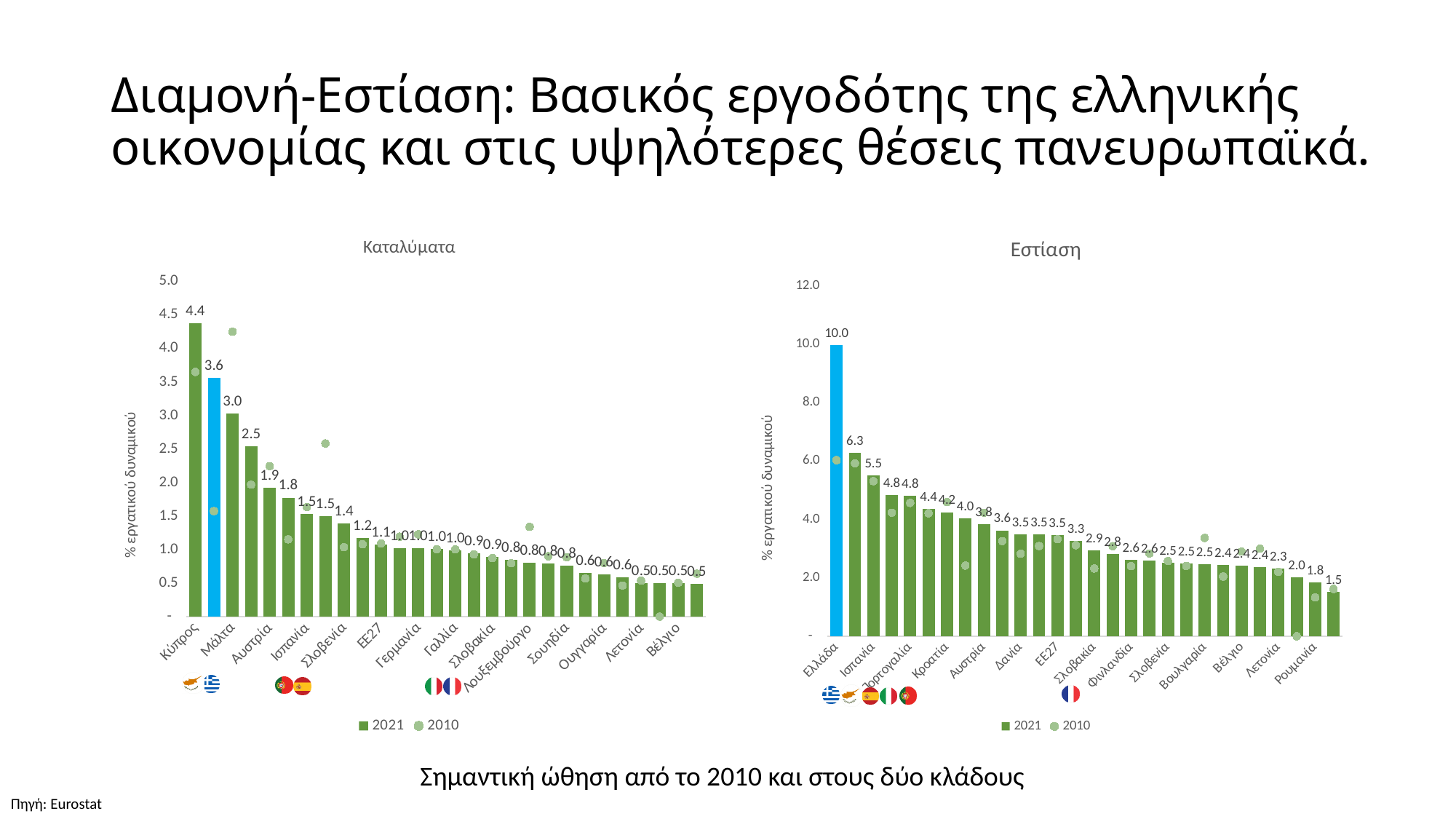
In the 'Εστίαση' chart, what is the difference between the first bar (10.0) and the second bar (6.3)? 3.7 What type of chart is the 'Καταλύματα' chart? bar chart In the 'Καταλύματα' chart, what is the value of the blue highlighted bar? 3.6 What is the lowest 2021 bar value shown in the 'Εστίαση' chart? 1.5 In the 'Εστίαση' chart, what is the 2021 value for Ελλάδα? 10.0 What are the two legend entries in the 'Καταλύματα' chart? 2021 and 2010 In the 'Εστίαση' chart, which category has the highest 2021 bar? Ελλάδα In the 'Εστίαση' chart, do the 2021 bar values rise or fall from left to right? fall Which is larger: the 2021 value for Ελλάδα in the 'Εστίαση' chart or the 2021 value for Κύπρος in the 'Καταλύματα' chart? Ελλάδα in the 'Εστίαση' chart In the 'Καταλύματα' chart, which category has the highest 2021 bar? Κύπρος In the 'Καταλύματα' chart, what is the 2021 value for Κύπρος? 4.4 How many series does the legend of the 'Εστίαση' chart list? 2